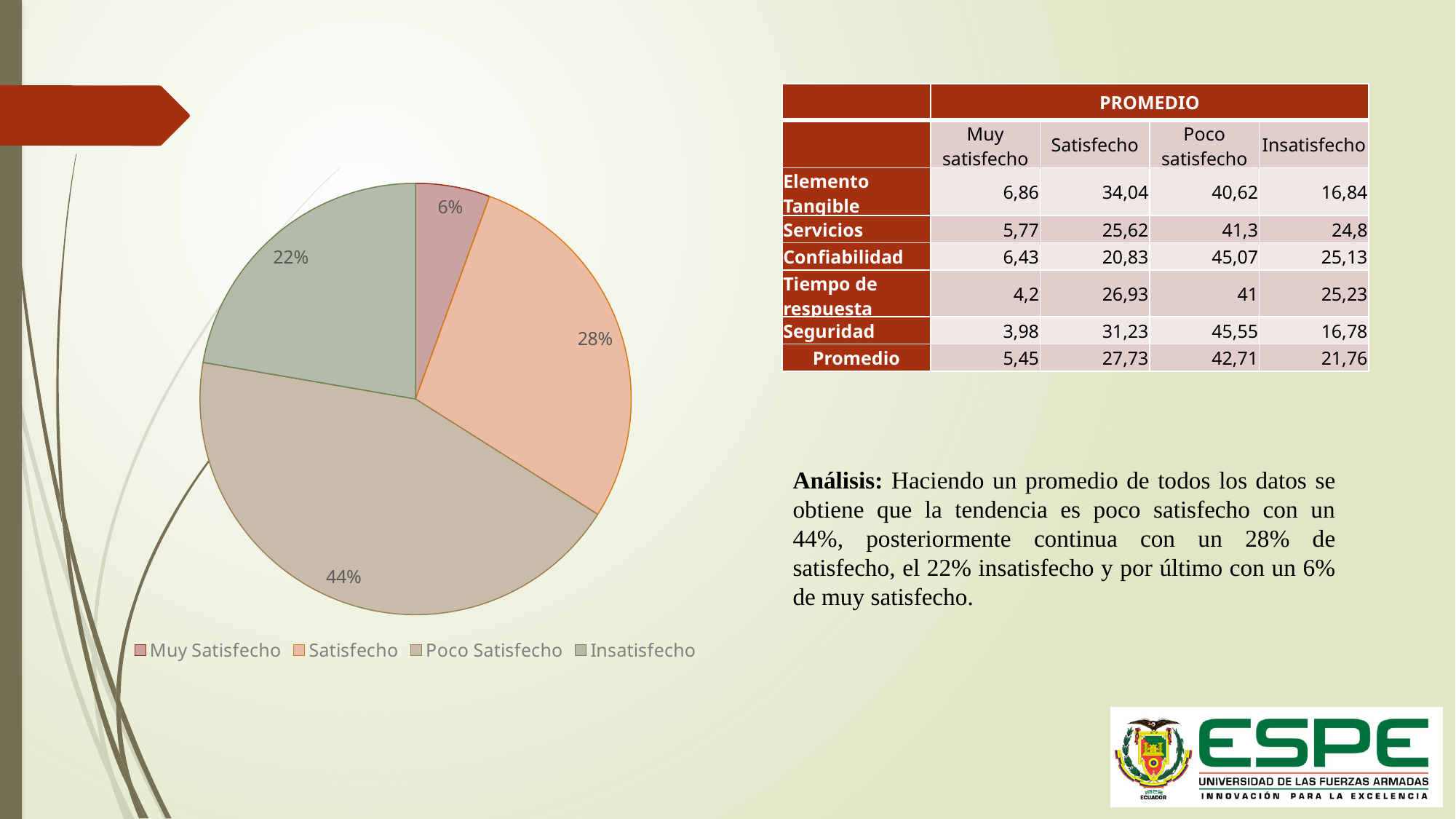
What kind of chart is shown on the slide? pie chart What percentage of the pie chart is Insatisfecho? 22% Which category has the largest slice of the pie chart? Poco Satisfecho Which category has the smallest slice of the pie chart? Muy Satisfecho What percentage of the pie chart is Satisfecho? 28% What percentage of the pie chart is Poco Satisfecho? 44% How many slices does the pie chart have? 4 What percentage of the pie chart is Muy Satisfecho? 6% What is the difference in percentage points between the Insatisfecho and Muy Satisfecho slices? 16 How many entries does the pie chart legend list? 4 What is the difference in percentage points between the Poco Satisfecho and Satisfecho slices? 16 Which slice is larger, Insatisfecho or Satisfecho? Satisfecho